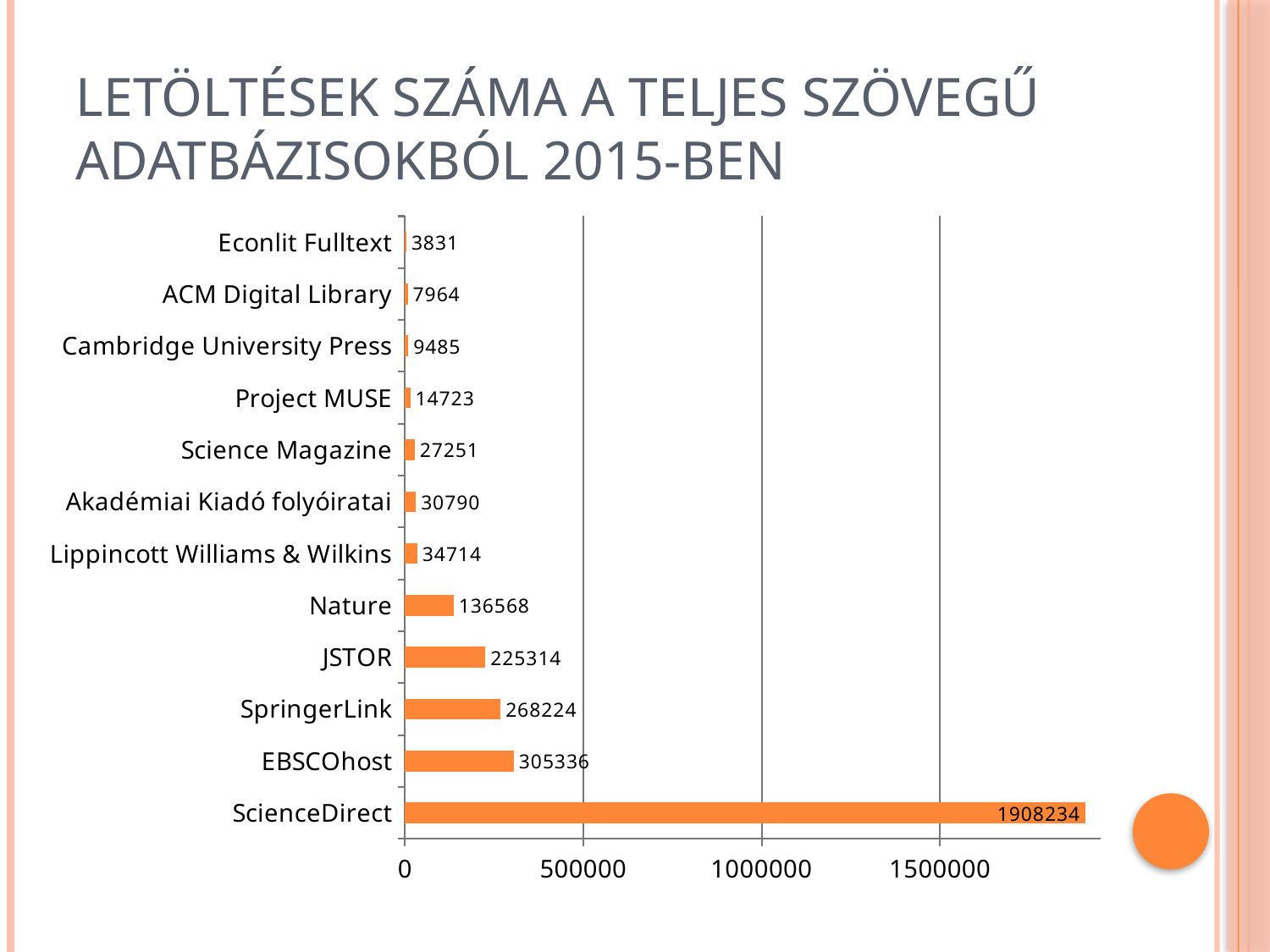
What is the number of downloads for JSTOR? 225314 How many databases are shown in the chart? 12 Which database has the lowest number of downloads? Econlit Fulltext Is the value for ScienceDirect greater or less than 1500000? greater Which database has the highest number of downloads? ScienceDirect What is the title of the slide? Letöltések száma a teljes szövegű adatbázisokból 2015-ben What is the difference between the downloads for EBSCOhost and SpringerLink? 37112 What colour are the bars in the chart? orange Which has more downloads, Nature or JSTOR? JSTOR What is the value shown for Akadémiai Kiadó folyóiratai? 30790 What kind of chart is shown on the slide? bar chart What is the number of downloads for ScienceDirect? 1908234